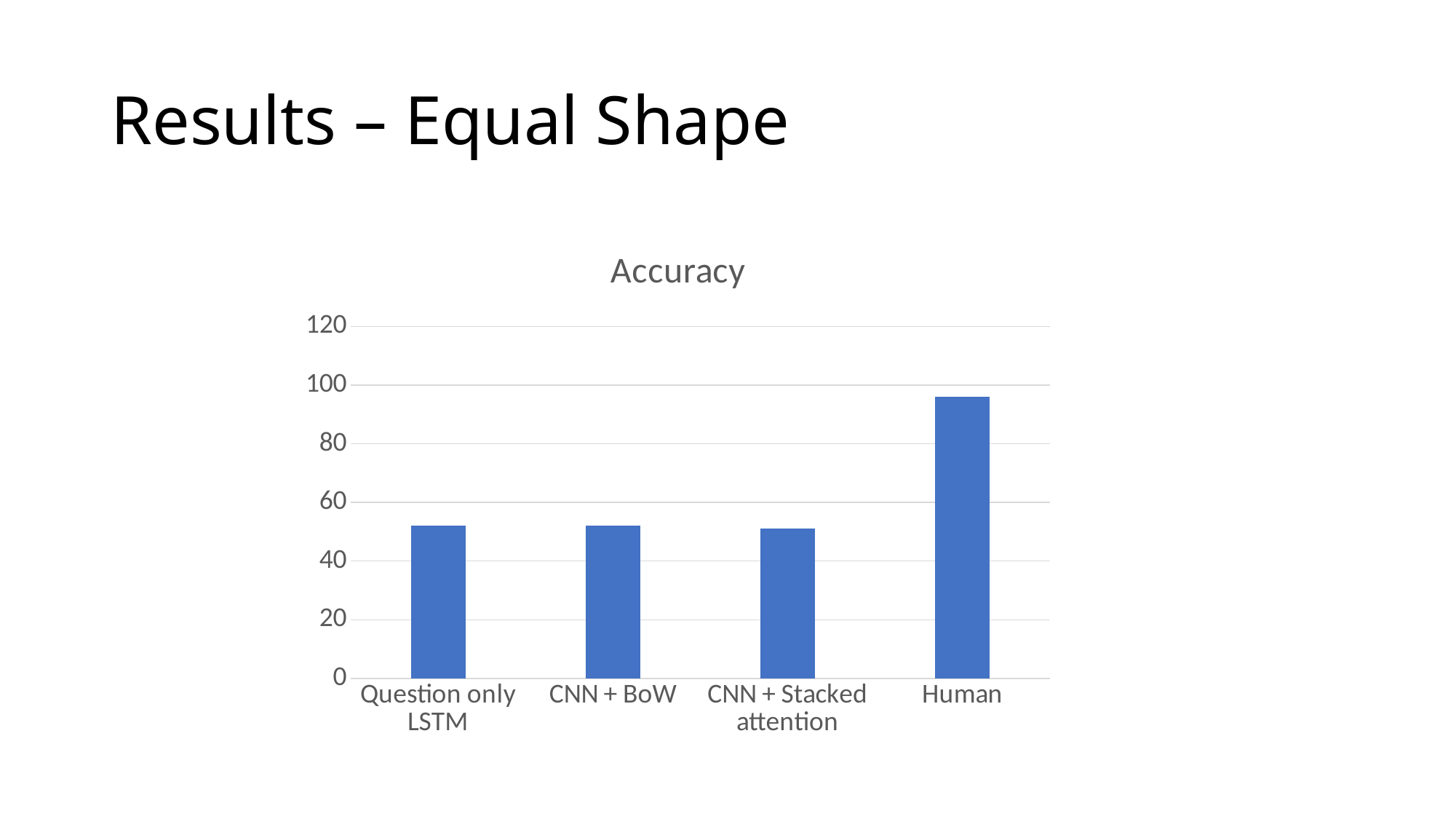
What kind of chart is shown on the slide? bar chart Is the value for CNN + BoW greater or less than 40? greater Is the value for Human greater or less than 100? less How many categories are shown on the x axis of the chart? 4 Is the value for CNN + Stacked attention greater or less than 60? less What is the highest value shown on the y axis of the chart? 120 Which category has the highest accuracy? Human Which is larger, the value for Question only LSTM or the value for Human? Human Which is larger, the value for Human or the value for CNN + Stacked attention? Human What is the title of the chart? Accuracy